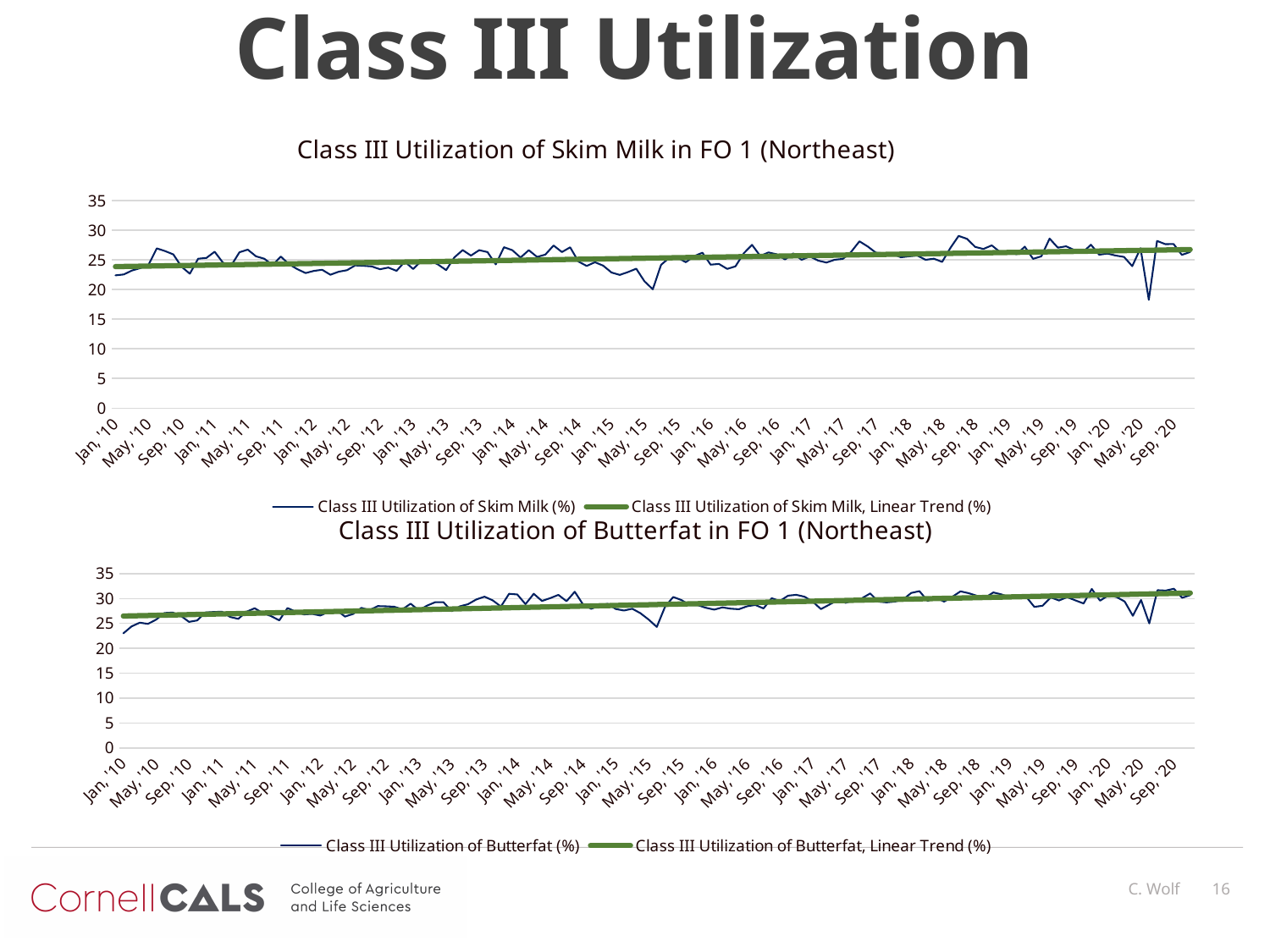
How many series does the legend of the bottom chart (Butterfat) list? 2 How many series does the legend of the top chart (Skim Milk) list? 2 What kind of chart is the bottom chart, 'Class III Utilization of Butterfat in FO 1 (Northeast)'? line chart In the bottom chart (Butterfat), is the value for Sep '20 greater or less than 30? greater In the bottom chart (Butterfat), is the value for Jan '10 greater or less than 25? less What kind of chart is the top chart, 'Class III Utilization of Skim Milk in FO 1 (Northeast)'? line chart What is the title of the top chart? Class III Utilization of Skim Milk in FO 1 (Northeast) In the top chart (Skim Milk), is the value for Jan '10 greater or less than 25? less In the bottom chart (Butterfat), does the linear trend line rise or fall from Jan '10 to Sep '20? rise In the top chart (Skim Milk), does the linear trend line rise or fall from Jan '10 to Sep '20? rise In the bottom chart, what is the name of the series drawn with the thick green line? Class III Utilization of Butterfat, Linear Trend (%)